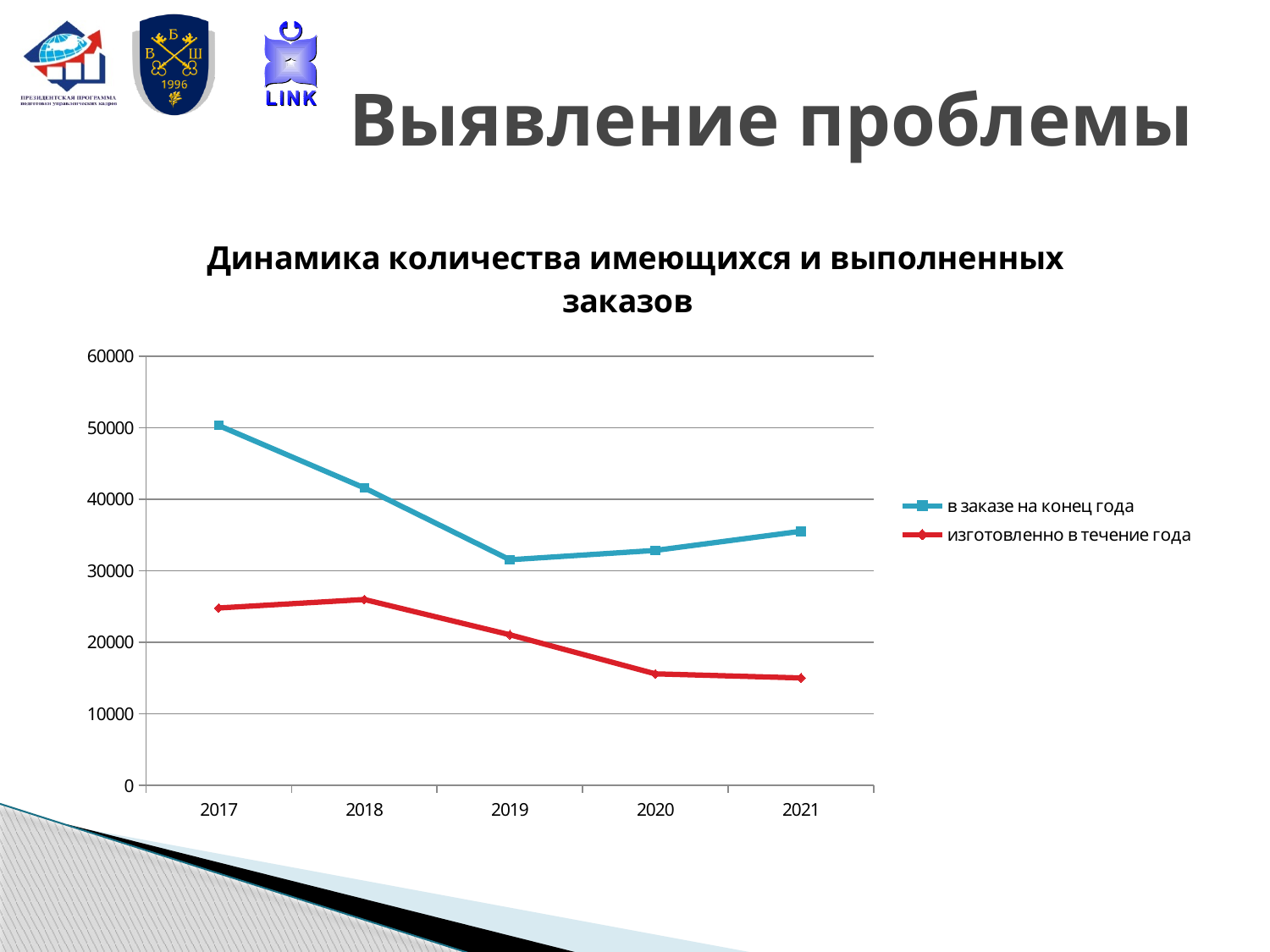
Is the value for 'в заказе на конец года' in 2019 greater or less than 40000? less In which year is the series 'изготовленно в течение года' at its highest? 2018 In 2021, which series has the larger value: 'в заказе на конец года' or 'изготовленно в течение года'? в заказе на конец года Is the value for 'изготовленно в течение года' in 2018 greater or less than 20000? greater Is the value for 'изготовленно в течение года' in 2020 greater or less than 20000? less In which year is the series 'в заказе на конец года' at its highest? 2017 How many years are plotted along the x axis? 5 Does the series 'изготовленно в течение года' rise or fall from 2018 to 2021? fall What kind of chart is shown on the slide? line chart What is the title of the chart? Динамика количества имеющихся и выполненных заказов How many series does the legend list? 2 In which year is the series 'в заказе на конец года' at its lowest? 2019